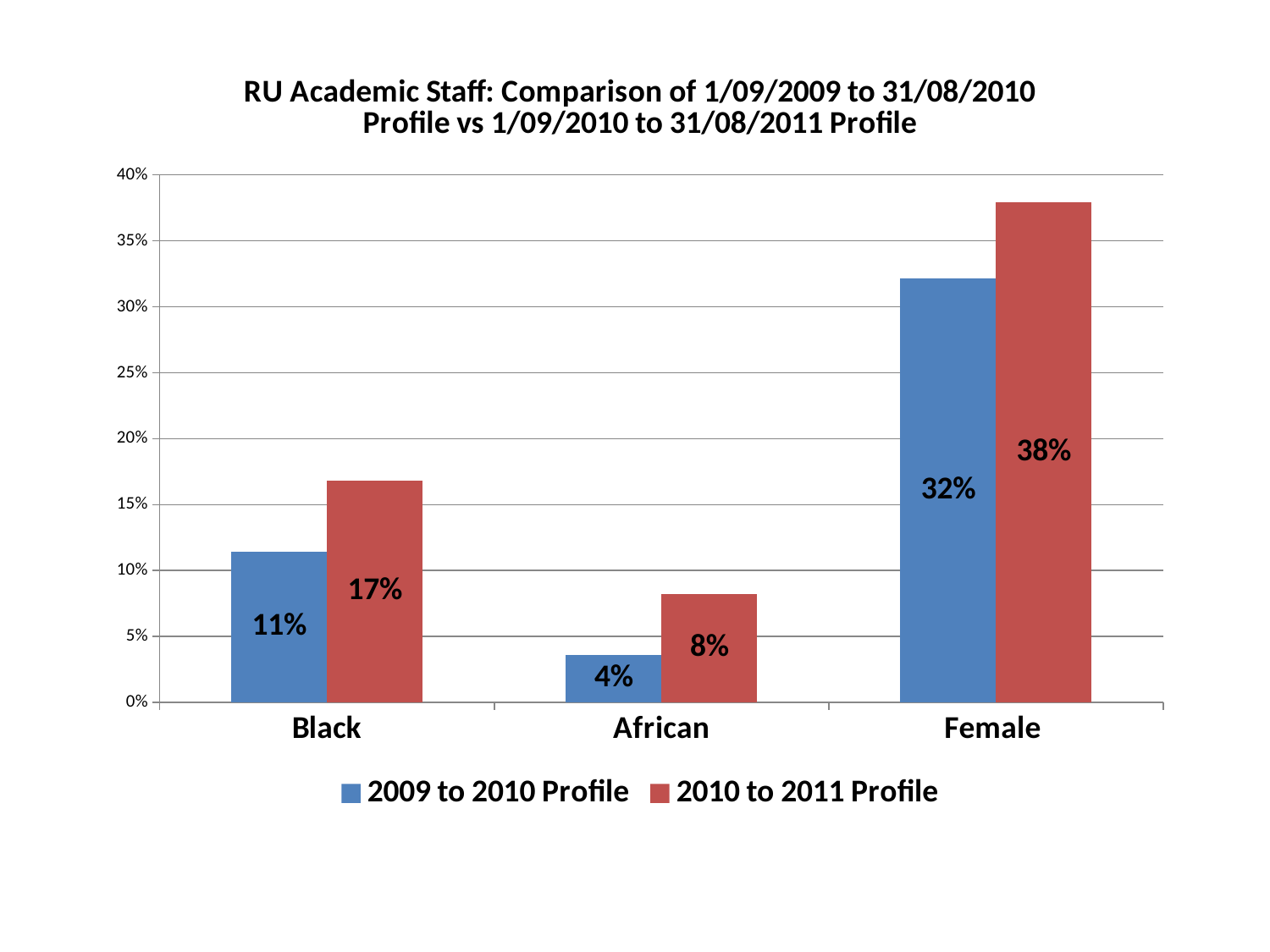
How many categories are shown on the x axis? 3 What is the value for African in the 2010 to 2011 Profile series? 8% What is the difference between the 2010 to 2011 Profile and 2009 to 2010 Profile values for Female? 6% How many series does the legend list? 2 What is the value for Black in the 2009 to 2010 Profile series? 11% What kind of chart is shown on the slide? Bar chart Is the 2009 to 2010 Profile value for Female greater or less than 30%? greater Which category has the lowest value in the 2010 to 2011 Profile series? African Which is larger for African: the 2009 to 2010 Profile value or the 2010 to 2011 Profile value? 2010 to 2011 Profile What is the value for Female in the 2010 to 2011 Profile series? 38% Which category has the highest value in the 2009 to 2010 Profile series? Female What is the difference between the 2010 to 2011 Profile and 2009 to 2010 Profile values for Black? 6%